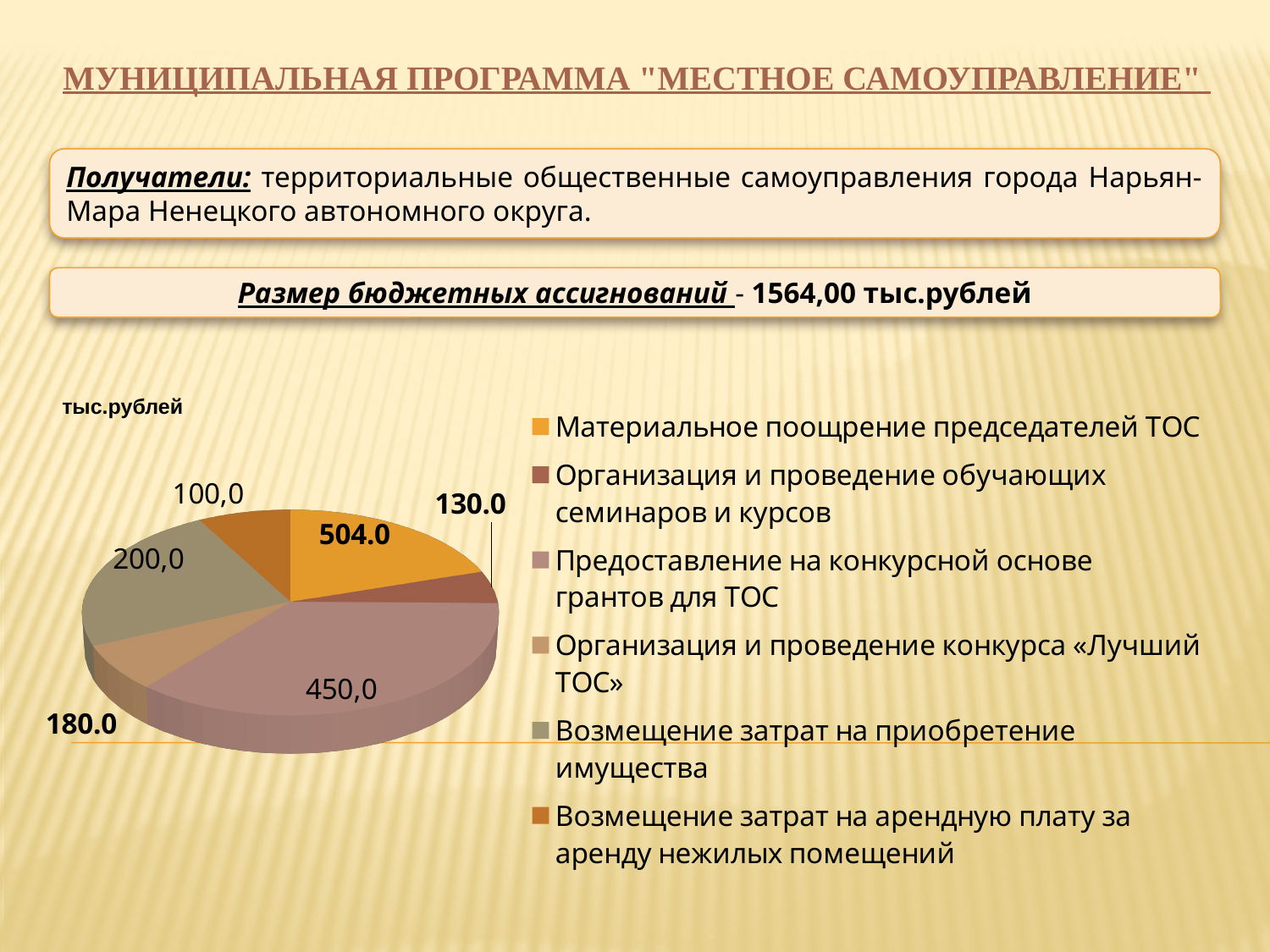
What is the value for «Возмещение затрат на арендную плату за аренду нежилых помещений»? 100,0 What is the value for «Организация и проведение обучающих семинаров и курсов»? 130.0 What type of chart is shown on the slide? pie chart How many categories does the pie chart have? 6 Which is larger: the value for «Возмещение затрат на приобретение имущества» or for «Организация и проведение конкурса «Лучший ТОС»»? Возмещение затрат на приобретение имущества What is the value for «Предоставление на конкурсной основе грантов для ТОС»? 450,0 What is the difference between the values for «Материальное поощрение председателей ТОС» and «Предоставление на конкурсной основе грантов для ТОС»? 54.0 What unit is indicated above the pie chart? тыс.рублей What is the value for «Материальное поощрение председателей ТОС»? 504.0 What is the value for «Возмещение затрат на приобретение имущества»? 200,0